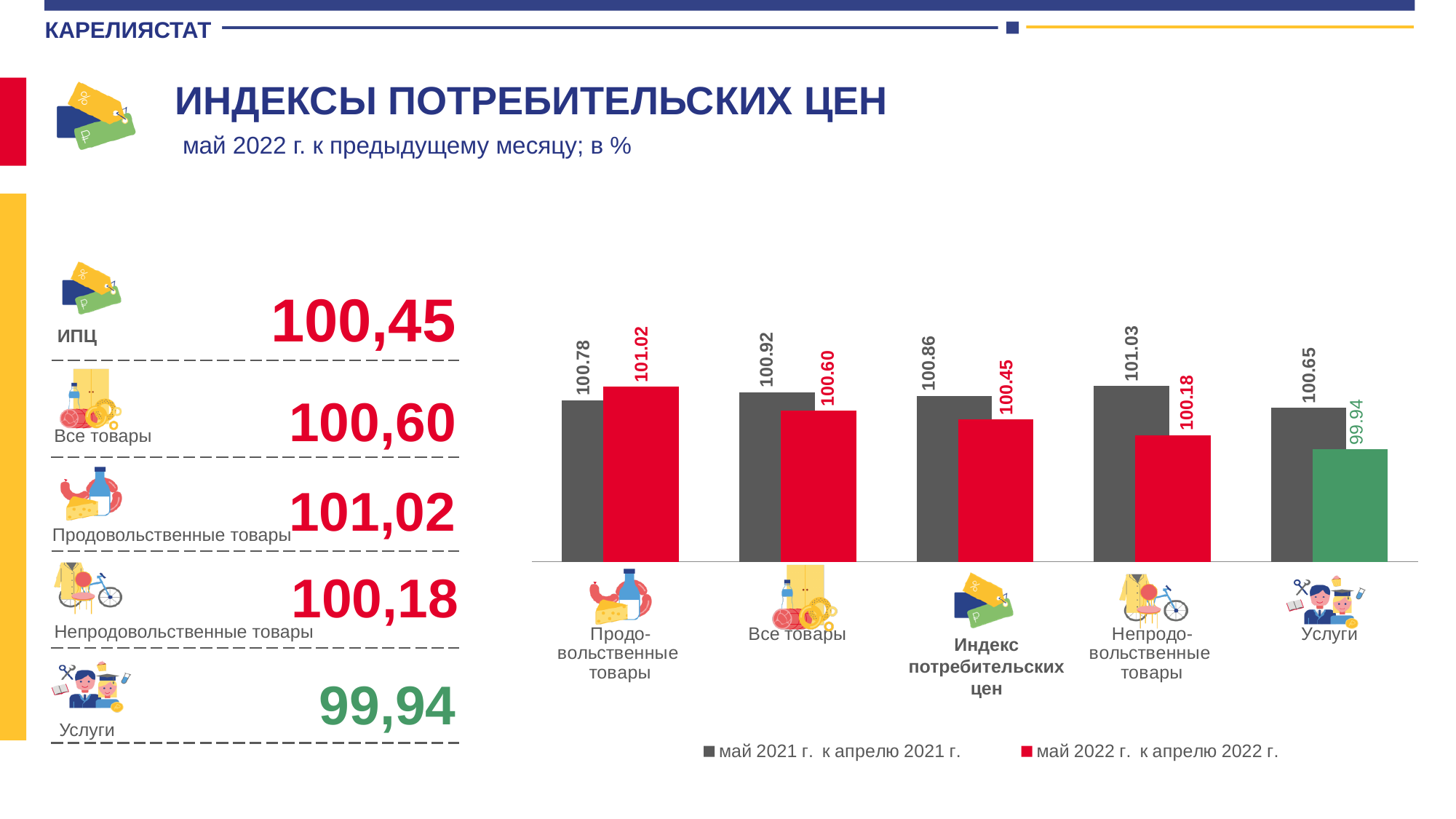
Which category has the highest value in the series 'май 2022 г. к апрелю 2022 г.'? Продовольственные товары For Все товары, which series has the larger value: 'май 2021 г. к апрелю 2021 г.' or 'май 2022 г. к апрелю 2022 г.'? май 2021 г. к апрелю 2021 г. Which category has the highest value in the series 'май 2021 г. к апрелю 2021 г.'? Непродовольственные товары What type of chart is shown on the slide? Bar chart What is the value for Непродовольственные товары in the series 'май 2022 г. к апрелю 2022 г.'? 100.18 What is the value for Продовольственные товары in the series 'май 2022 г. к апрелю 2022 г.'? 101.02 What is the value for Услуги in the series 'май 2021 г. к апрелю 2021 г.'? 100.65 Which category has the lowest value in the series 'май 2022 г. к апрелю 2022 г.'? Услуги How many series does the chart legend list? 2 How many categories are shown on the x axis of the chart? 5 What colour are the bars for the series 'май 2021 г. к апрелю 2021 г.'? Dark grey What is the difference between the 'май 2022 г. к апрелю 2022 г.' and 'май 2021 г. к апрелю 2021 г.' values for Непродовольственные товары? -0.85